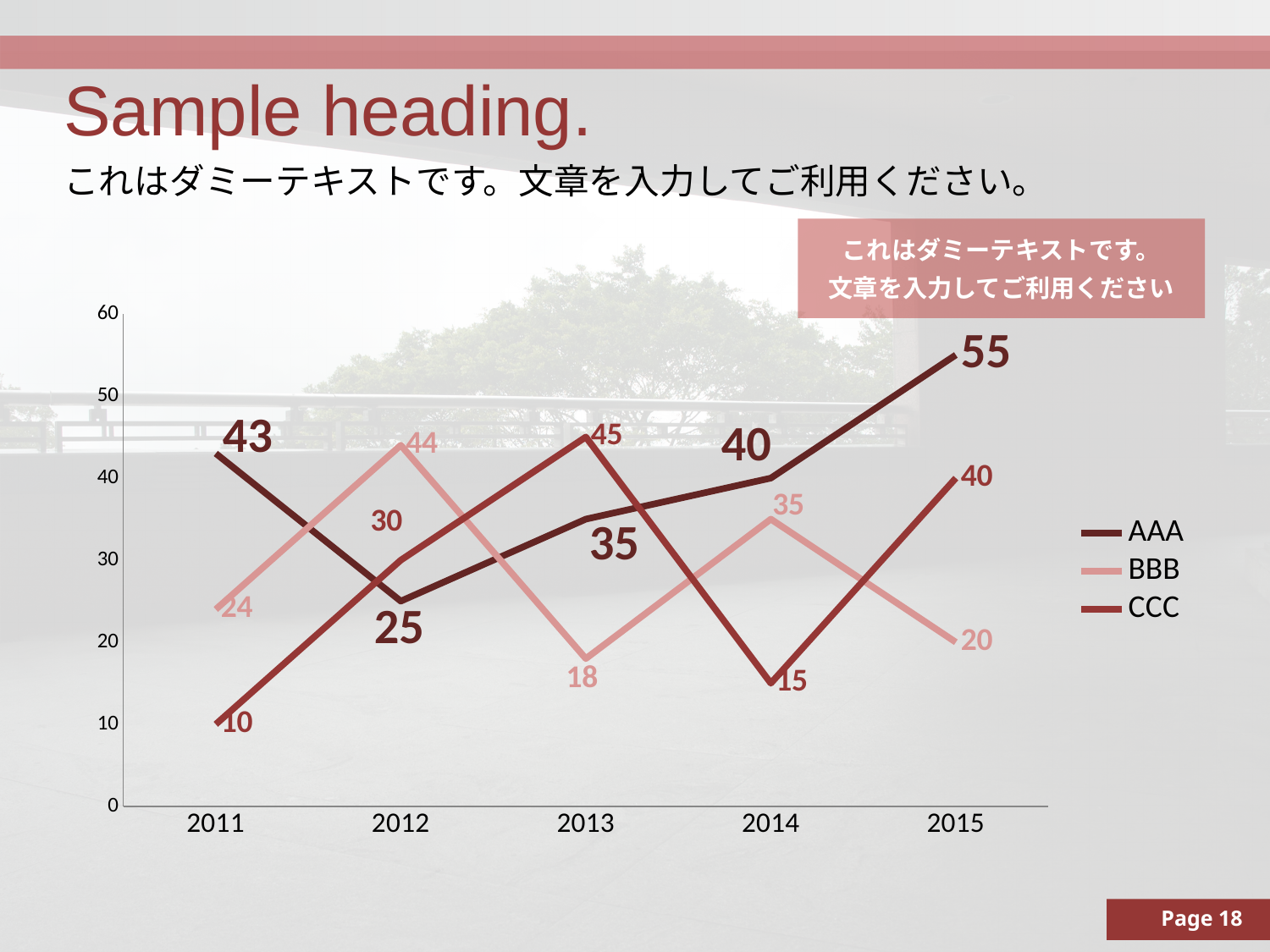
What is the value of AAA in 2015? 55 How many series does the legend list? 3 In which year does CCC have its lowest value? 2011 What is the difference between AAA and BBB in 2015? 35 Which series has the higher value in 2012, AAA or BBB? BBB In which year does AAA reach its highest value? 2015 What is the value of BBB in 2013? 18 How many years are shown on the x axis? 5 Which series has the higher value in 2014, CCC or BBB? BBB Does the AAA series rise or fall from 2012 to 2015? Rise What kind of chart is shown on the slide? Line chart What is the value of CCC in 2011? 10